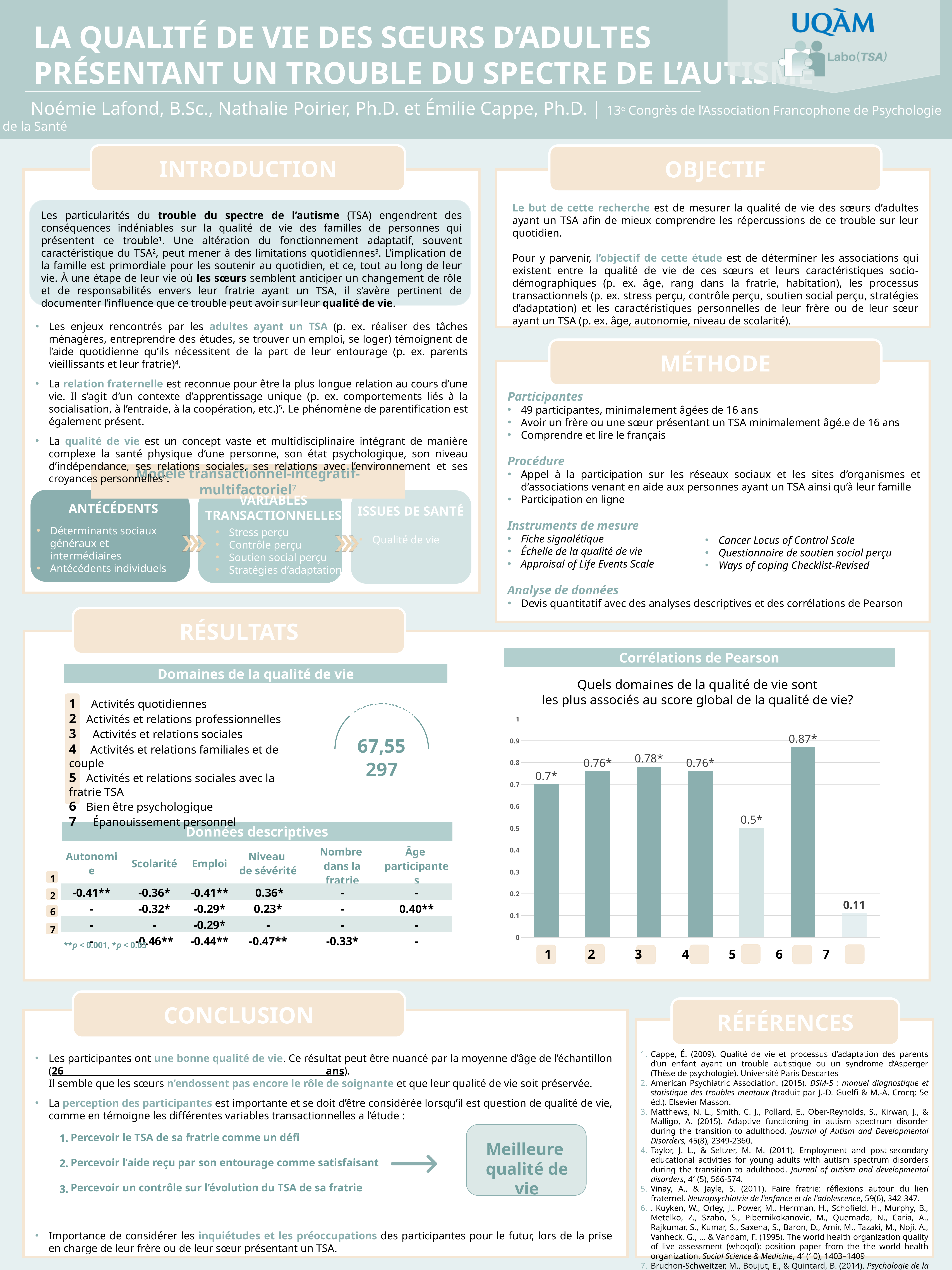
What kind of chart is shown under the heading Corrélations de Pearson? bar chart In the Corrélations de Pearson chart, which category has the highest bar? 6 In the Corrélations de Pearson chart, what is the data label on the bar for category 7? 0.11 In the Corrélations de Pearson chart, which is larger, the value for category 3 or the value for category 5? category 3 In the Corrélations de Pearson chart, which category has the lowest bar? 7 In the Corrélations de Pearson chart, what is the difference between the values for category 6 and category 7? 0.76 In the Corrélations de Pearson chart, is the value for category 5 greater or less than 0.6? less In the Corrélations de Pearson chart, what is the data label on the bar for category 6? 0.87* What question is written above the Corrélations de Pearson bar chart? Quels domaines de la qualité de vie sont les plus associés au score global de la qualité de vie? In the Corrélations de Pearson chart, what is the data label on the bar for category 1? 0.7* How many bars are plotted in the Corrélations de Pearson chart? 7 In the Corrélations de Pearson chart, what is the data label on the bar for category 5? 0.5*